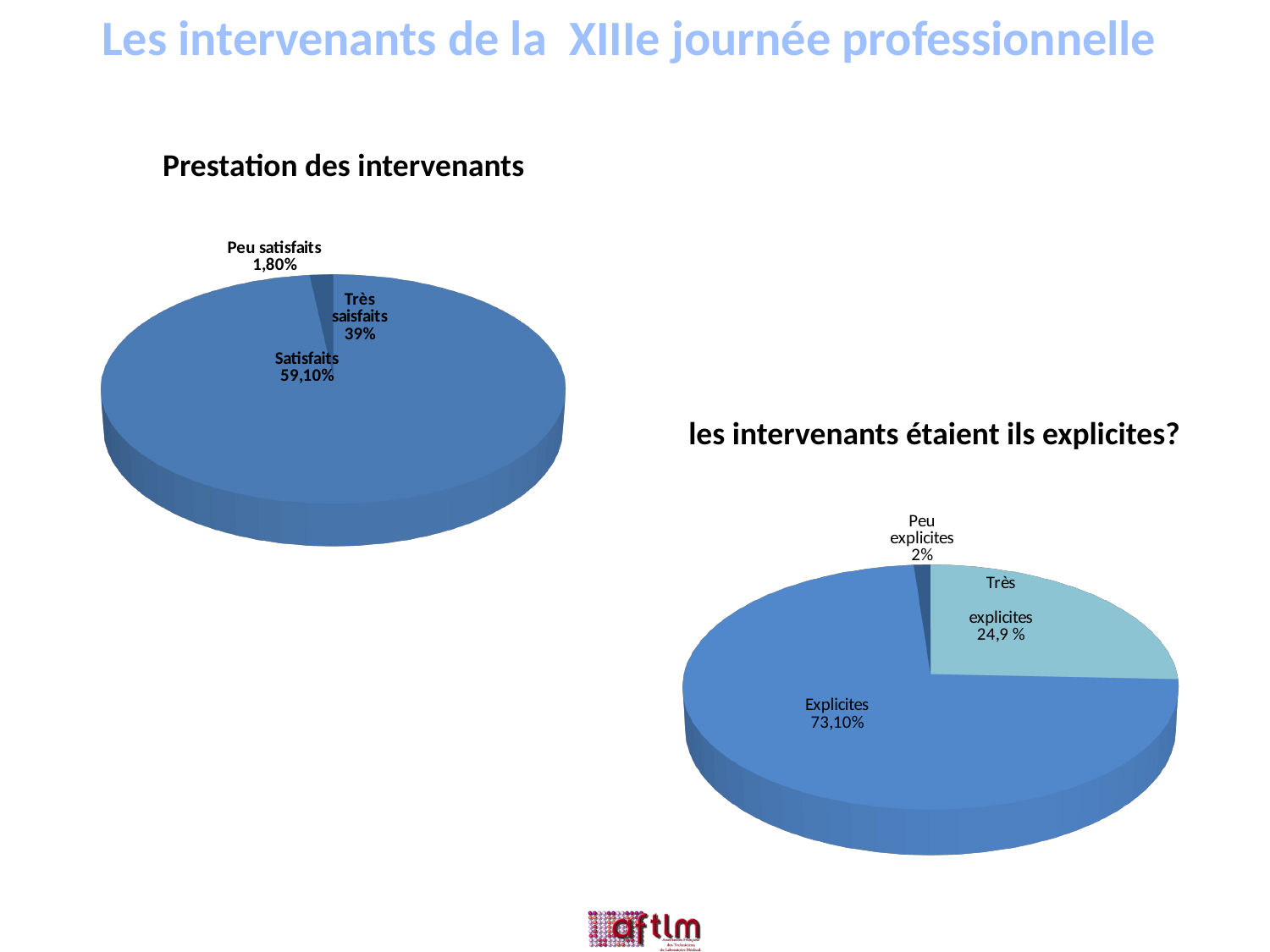
What type of chart is used for 'les intervenants étaient ils explicites?'? Pie chart In the 'les intervenants étaient ils explicites?' chart, what share is labelled for 'Explicites'? 73,10% In the 'les intervenants étaient ils explicites?' chart, which category has the largest share? Explicites In the 'Prestation des intervenants' chart, which category has the smallest share? Peu satisfaits In the 'Prestation des intervenants' chart, which category has the largest share? Satisfaits In the 'les intervenants étaient ils explicites?' chart, which is larger: 'Très explicites' or 'Peu explicites'? Très explicites In the 'Prestation des intervenants' chart, what share is labelled for 'Très saisfaits'? 39% In the 'Prestation des intervenants' chart, how many categories are shown? 3 In the 'Prestation des intervenants' chart, what share is labelled for 'Satisfaits'? 59,10% In the 'Prestation des intervenants' chart, what share is labelled for 'Peu satisfaits'? 1,80% In the 'les intervenants étaient ils explicites?' chart, what share is labelled for 'Très explicites'? 24,9 % In the 'les intervenants étaient ils explicites?' chart, what share is labelled for 'Peu explicites'? 2%